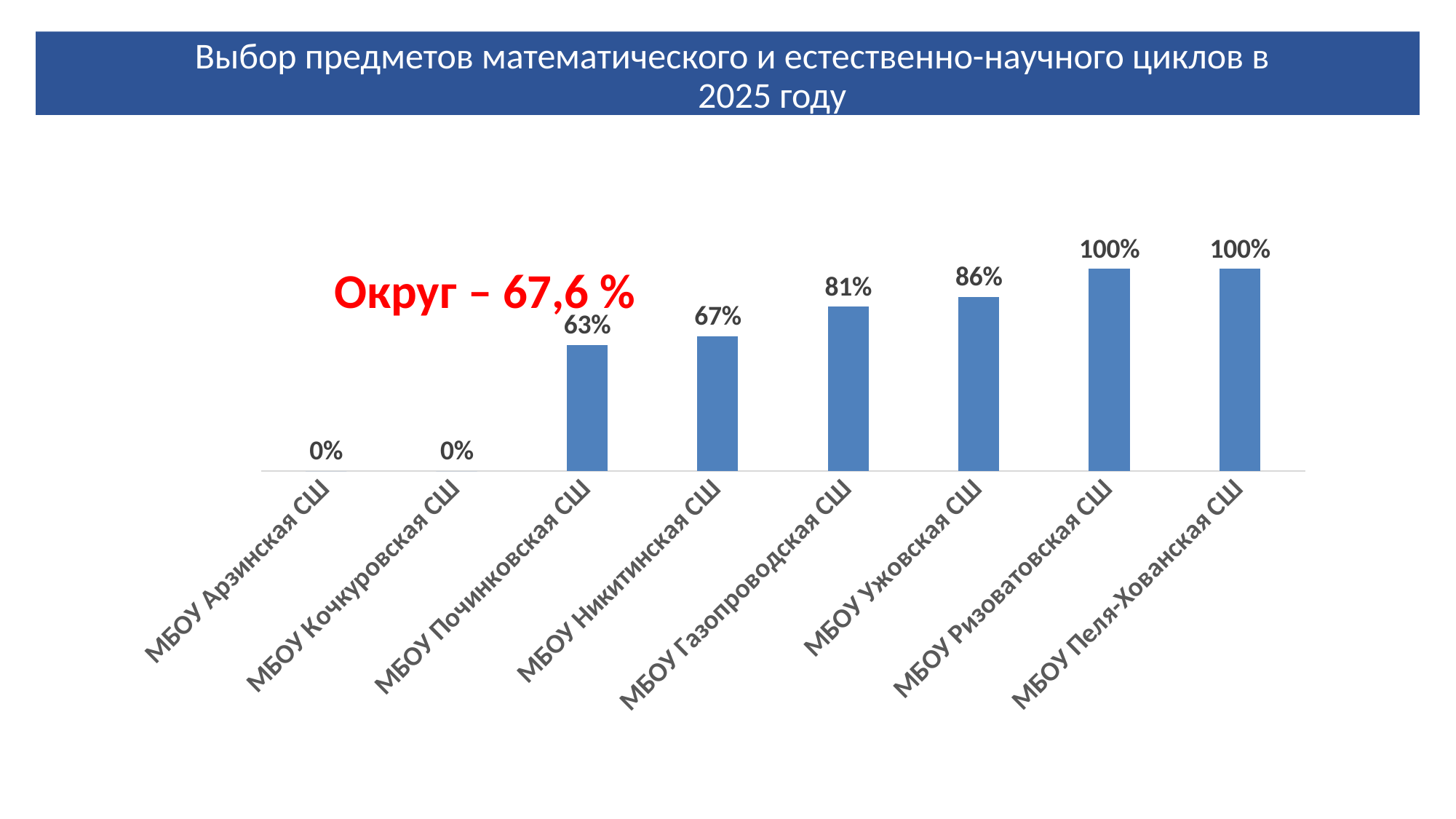
What is the value for МБОУ Ужовская СШ? 86% What value is given for the district (Округ) in the red text on the chart? 67,6 % What kind of chart is shown on the slide? Bar chart Which is larger, the value for МБОУ Газопроводская СШ or МБОУ Никитинская СШ? МБОУ Газопроводская СШ How many categories are shown on the chart? 8 What is the value for МБОУ Починковская СШ? 63% Which category has the lowest value among those with a non-zero bar? МБОУ Починковская СШ Do the values rise or fall from left to right along the x axis? Rise How many categories have a value of 100%? 2 What is the value for МБОУ Арзинская СШ? 0% What is the value for МБОУ Газопроводская СШ? 81% What is the difference between the values for МБОУ Ужовская СШ and МБОУ Никитинская СШ? 19%